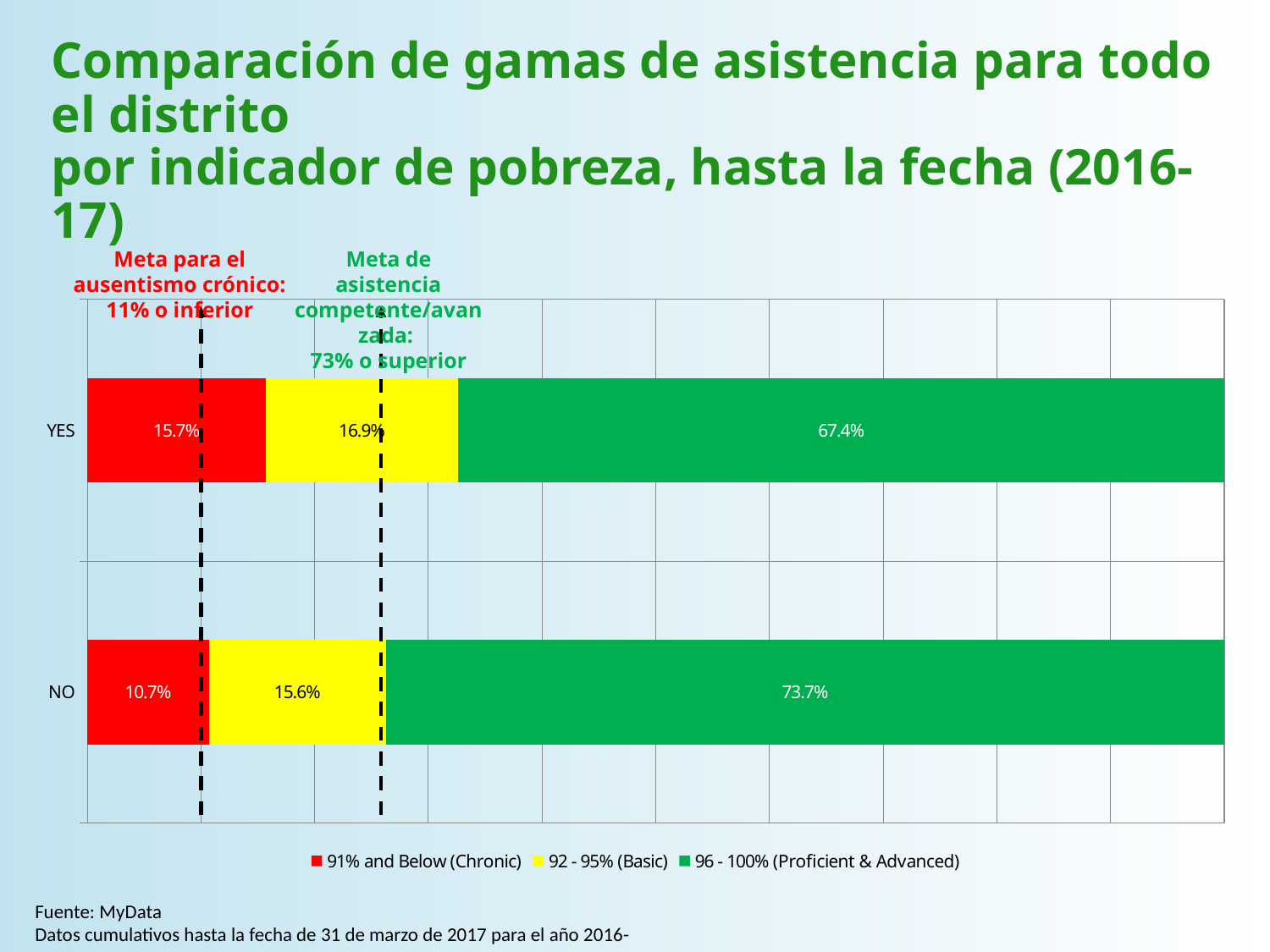
What is the difference between the 91% and Below (Chronic) values for YES and NO? 5.0% Which category has the higher value for the 91% and Below (Chronic) series, YES or NO? YES Which category has the higher value for the 96 - 100% (Proficient & Advanced) series, YES or NO? NO What is the difference between the 96 - 100% (Proficient & Advanced) values for NO and YES? 6.3% How many categories are plotted on the chart? 2 What is the value of the 91% and Below (Chronic) series for YES? 15.7% What is the value of the 96 - 100% (Proficient & Advanced) series for NO? 73.7% How many series does the legend list? 3 What is the value of the 96 - 100% (Proficient & Advanced) series for YES? 67.4% What kind of chart is shown on the slide? Stacked bar chart What is the value of the 92 - 95% (Basic) series for NO? 15.6% Which colour represents the 92 - 95% (Basic) series in the legend? Yellow